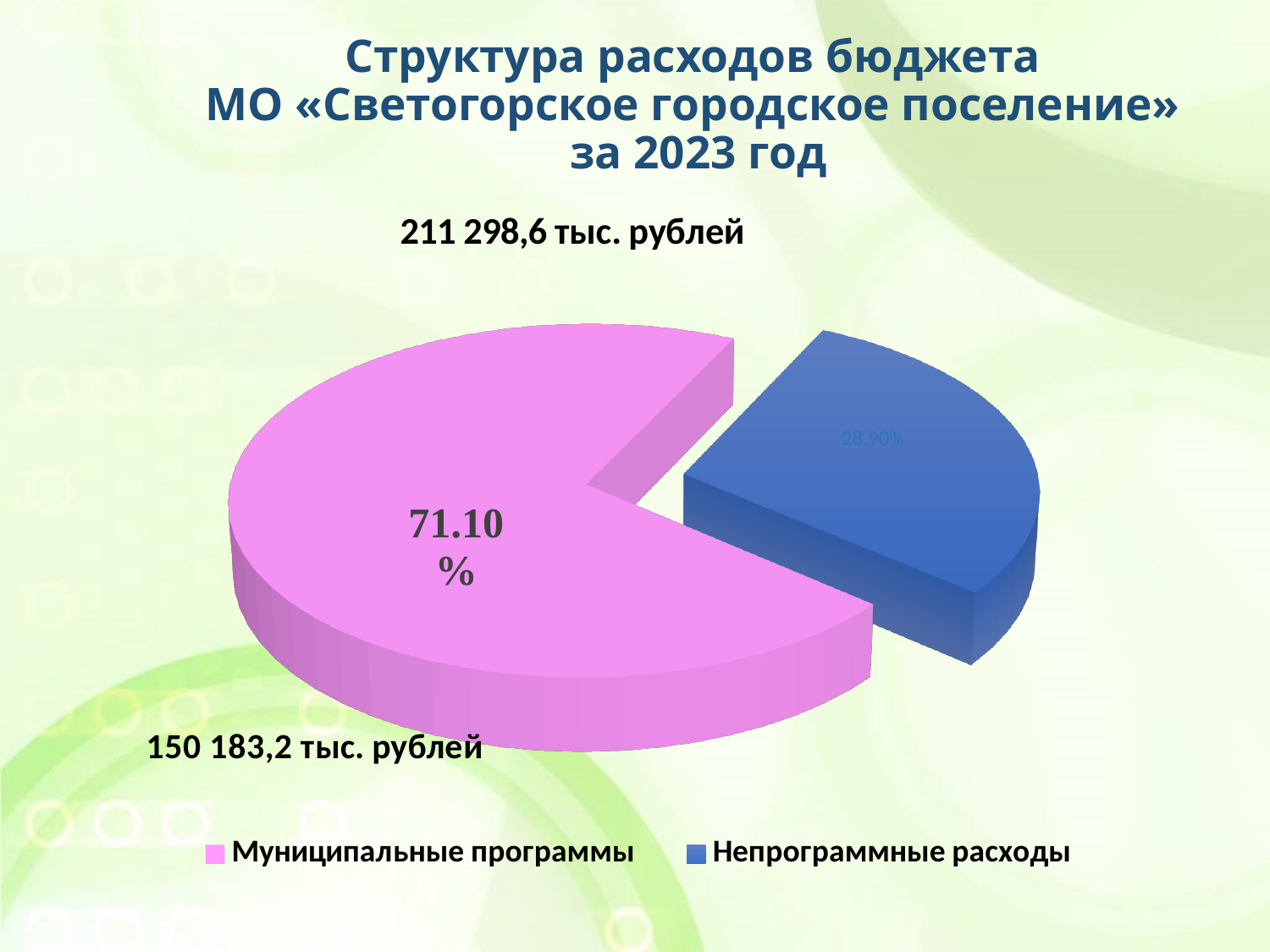
What colour is the Непрограммные расходы slice? Blue What share of the pie does Муниципальные программы hold? 71.10% Which is larger: the share for Муниципальные программы or the share for Непрограммные расходы? Муниципальные программы What kind of chart is shown on the slide? Pie chart How many entries does the legend list? 2 What total amount is printed above the pie chart? 211 298,6 тыс. рублей What share of the pie does Непрограммные расходы hold? 28.90% Which category has the smallest slice of the pie? Непрограммные расходы Which category has the largest slice of the pie? Муниципальные программы What amount in тыс. рублей is printed next to the Муниципальные программы slice? 150 183,2 тыс. рублей How many slices does the pie chart have? 2 What is the difference in percentage points between the Муниципальные программы share and the Непрограммные расходы share? 42.20%